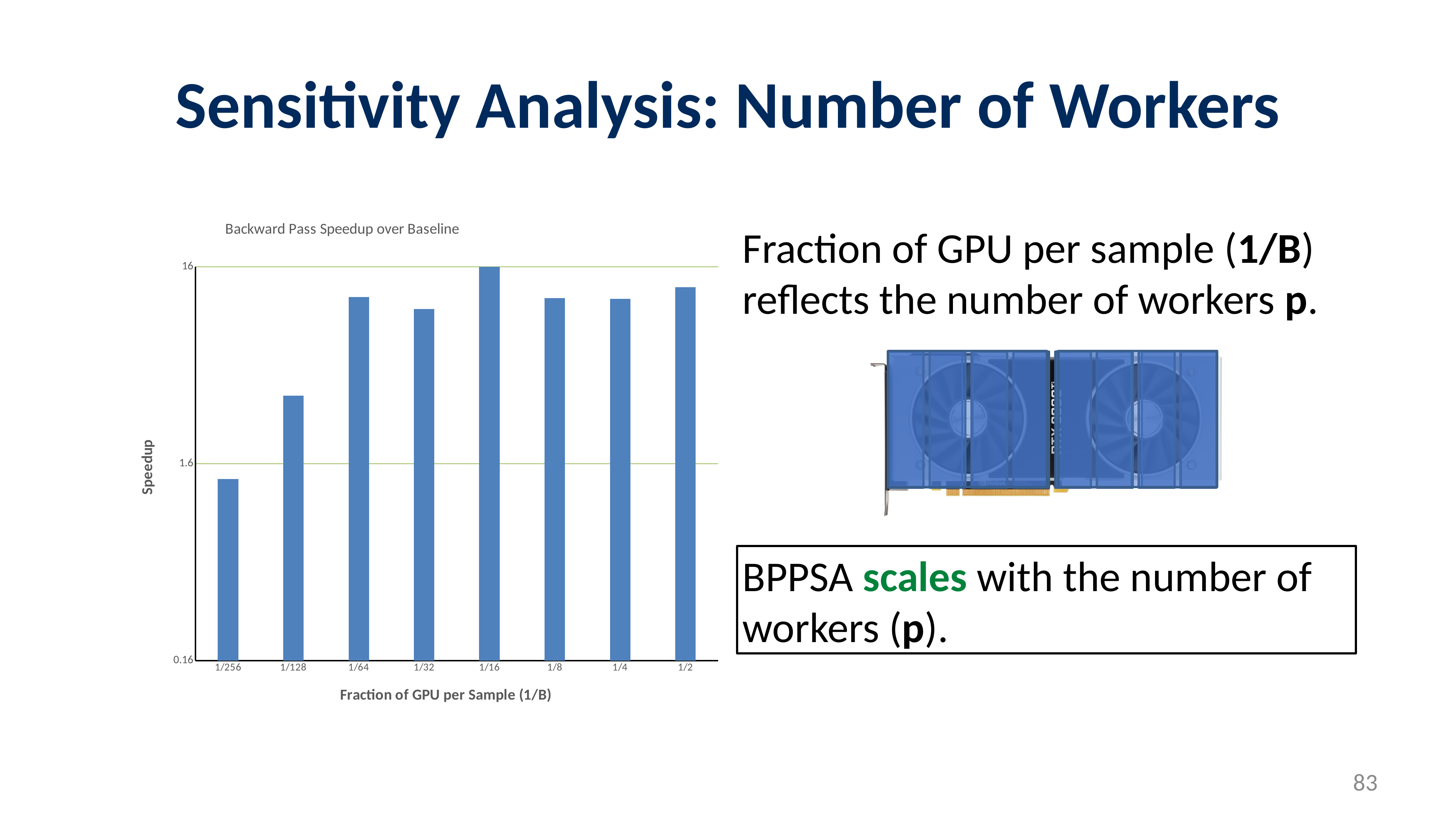
What is the title of the chart? Backward Pass Speedup over Baseline Which fraction of GPU per sample has the highest backward pass speedup? 1/16 What type of chart is shown on the slide? Bar chart What is the label of the x axis of the chart? Fraction of GPU per Sample (1/B) Is the speedup for 1/256 greater or less than 1.6? less Which has a larger speedup, 1/128 or 1/64? 1/64 What is the speedup value for 1/16, which lands on an axis tick? 16 Is the speedup for 1/2 greater or less than 16? less Is the speedup for 1/128 greater or less than 1.6? greater How many bars (categories) are plotted in the chart? 8 Which has a larger speedup, 1/256 or 1/128? 1/128 Which fraction of GPU per sample has the lowest backward pass speedup? 1/256